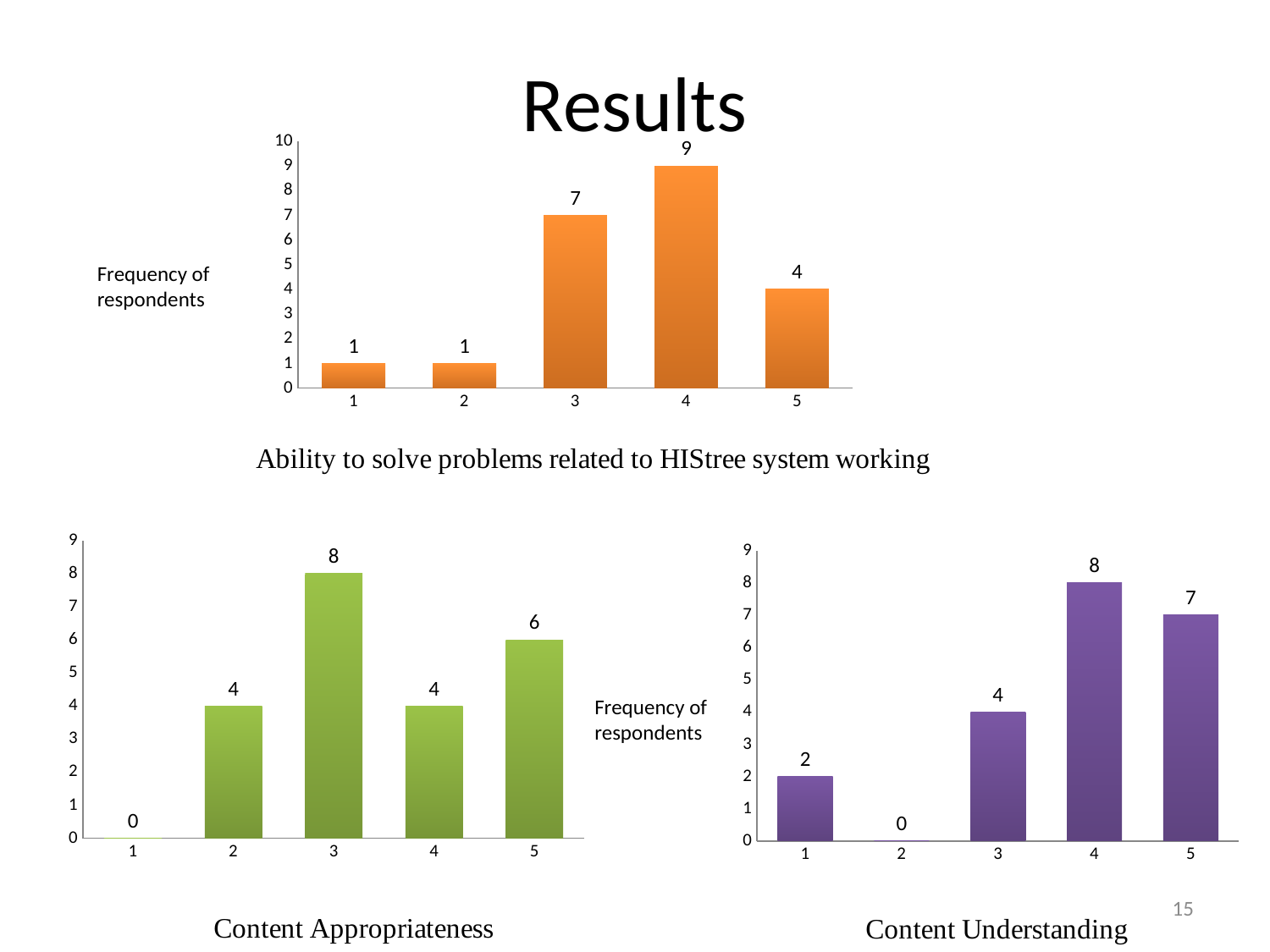
What colour are the bars in the 'Content Understanding' chart? purple In the 'Ability to solve problems related to HIStree system working' chart, what is the difference between the values for categories 4 and 3? 2 In the 'Content Appropriateness' chart, what is the value for category 3? 8 In the 'Content Appropriateness' chart, which category has the lowest value? 1 In the 'Content Understanding' chart, what is the difference between the values for categories 4 and 5? 1 In the 'Content Appropriateness' chart, is the value for category 5 larger or smaller than the value for category 4? larger In the 'Ability to solve problems related to HIStree system working' chart, which category has the highest frequency? 4 In the 'Content Understanding' chart, what is the value for category 1? 2 How many categories are shown on the x axis of the 'Content Understanding' chart? 5 What type of chart is the 'Content Appropriateness' chart? bar chart In the 'Ability to solve problems related to HIStree system working' chart, what is the frequency of respondents for category 4? 9 In the 'Content Understanding' chart, which category has the highest value? 4